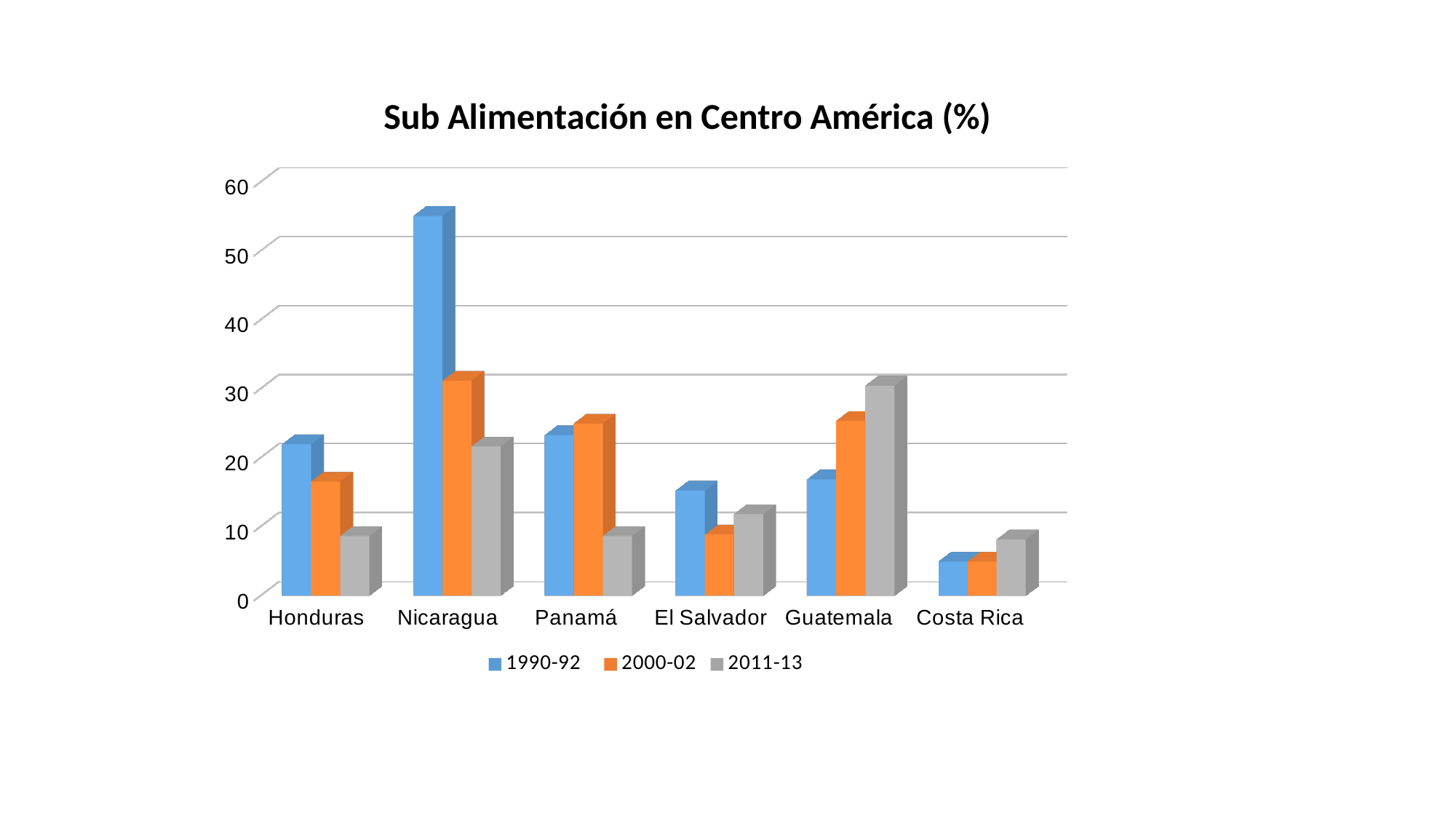
How many countries are shown on the x axis of the chart? 6 Which country has the highest value for the 1990-92 series? Nicaragua For Honduras, do the values rise or fall from 1990-92 to 2011-13? fall Is the 1990-92 value for Nicaragua greater or less than 50? greater Which country has the lowest value for the 1990-92 series? Costa Rica Which country has the highest value for the 2011-13 series? Guatemala How many series does the legend list? 3 What kind of chart is shown on the slide? bar chart For Guatemala, which series has the larger value: 1990-92 or 2011-13? 2011-13 Is the 2011-13 value for Honduras greater or less than 10? less What is the title of the chart? Sub Alimentación en Centro América (%) For Guatemala, do the values rise or fall from 1990-92 to 2011-13? rise